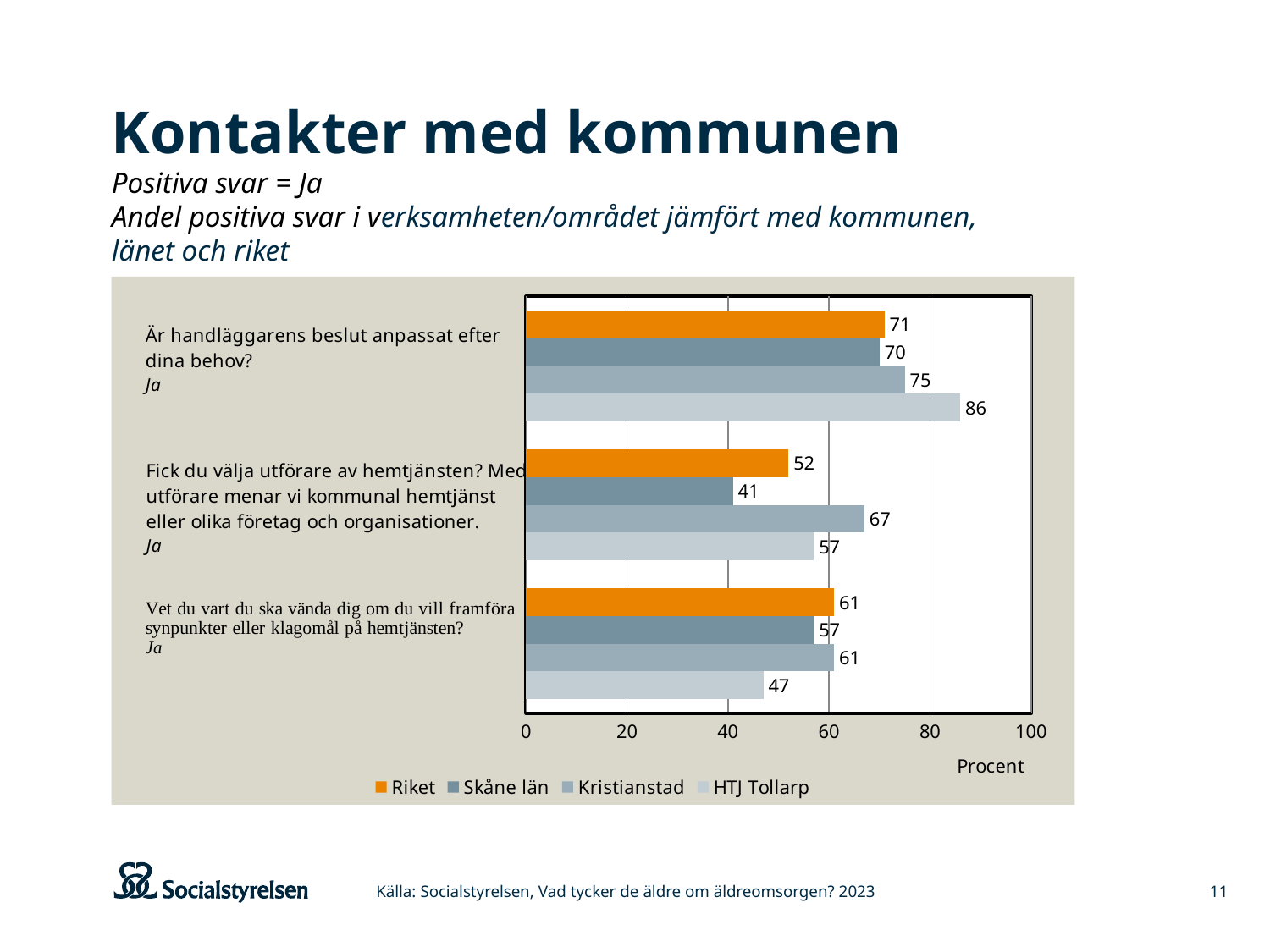
How many series does the legend list? 4 Which series has the lowest value on the question "Vet du vart du ska vända dig om du vill framföra synpunkter eller klagomål på hemtjänsten?"? HTJ Tollarp Which is larger on the question "Fick du välja utförare av hemtjänsten?": Riket or HTJ Tollarp? HTJ Tollarp What is the difference between HTJ Tollarp and Riket on the question "Är handläggarens beslut anpassat efter dina behov?"? 15 What is the value for HTJ Tollarp on the question "Är handläggarens beslut anpassat efter dina behov?"? 86 Which series has the highest value on the question "Är handläggarens beslut anpassat efter dina behov?"? HTJ Tollarp What is the value for Riket on the question "Vet du vart du ska vända dig om du vill framföra synpunkter eller klagomål på hemtjänsten?"? 61 What unit is shown on the x axis of the chart? Procent What is the difference between Kristianstad and Skåne län on the question "Fick du välja utförare av hemtjänsten?"? 26 What kind of chart is shown on the slide? Bar chart How many question categories are shown on the chart? 3 What is the value for Skåne län on the question "Fick du välja utförare av hemtjänsten?"? 41